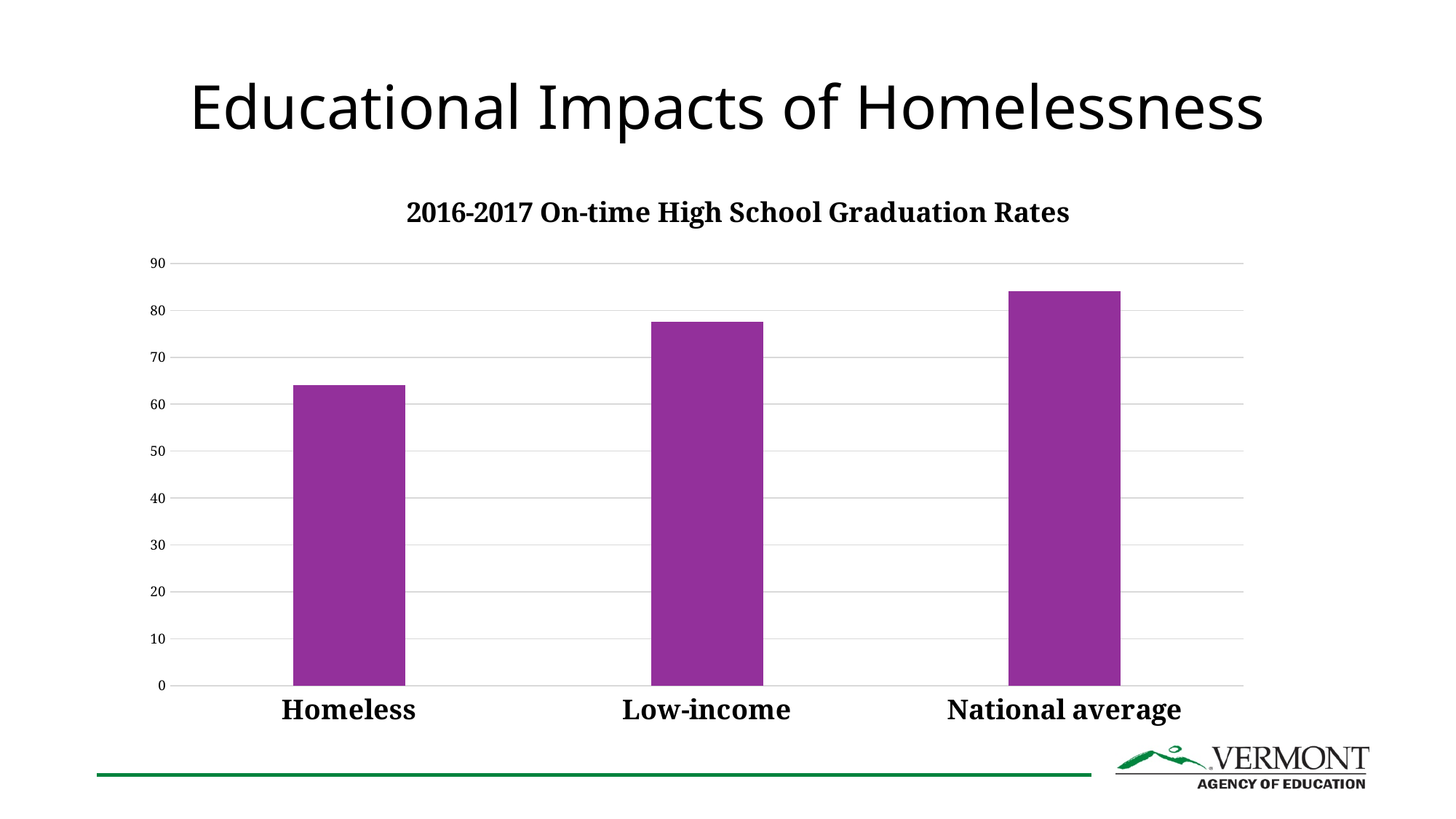
Is the value for Homeless greater or less than 60? greater Is the value for National average greater or less than 80? greater Is the value for Low-income greater or less than 80? less Which category has the lowest graduation rate? Homeless What kind of chart is shown on the slide? bar chart How many categories are shown on the x axis of the chart? 3 What is the title of the chart? 2016-2017 On-time High School Graduation Rates Do the values rise or fall from left to right across the x axis? rise What colour are the bars in the chart? purple Which is larger, the value for Homeless or the value for Low-income? Low-income Which category has the highest graduation rate? National average